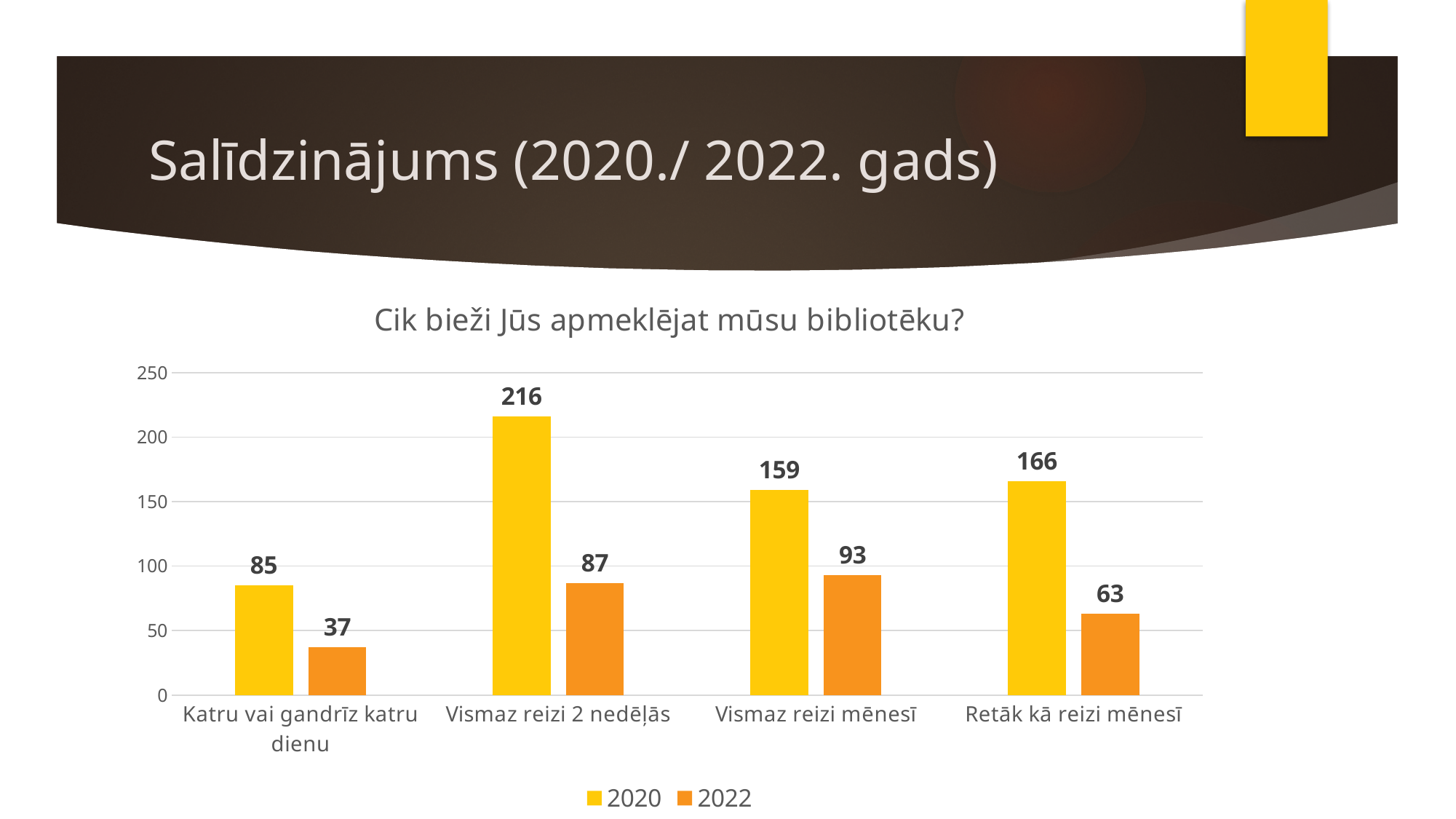
How many series does the legend list? 2 What kind of chart is shown on the slide? Bar chart What is the 2022 value for "Katru vai gandrīz katru dienu"? 37 What is the 2020 value for "Vismaz reizi 2 nedēļās"? 216 Which category has the highest 2020 value? Vismaz reizi 2 nedēļās What is the difference between the 2020 and 2022 values for "Vismaz reizi mēnesī"? 66 What is the title of the chart? Cik bieži Jūs apmeklējat mūsu bibliotēku? Which category has the lowest 2022 value? Katru vai gandrīz katru dienu Which is larger for "Retāk kā reizi mēnesī": the 2020 value or the 2022 value? 2020 What is the 2022 value for "Retāk kā reizi mēnesī"? 63 Is the 2020 value for "Vismaz reizi mēnesī" greater or less than 150? greater How many categories are shown on the x axis? 4